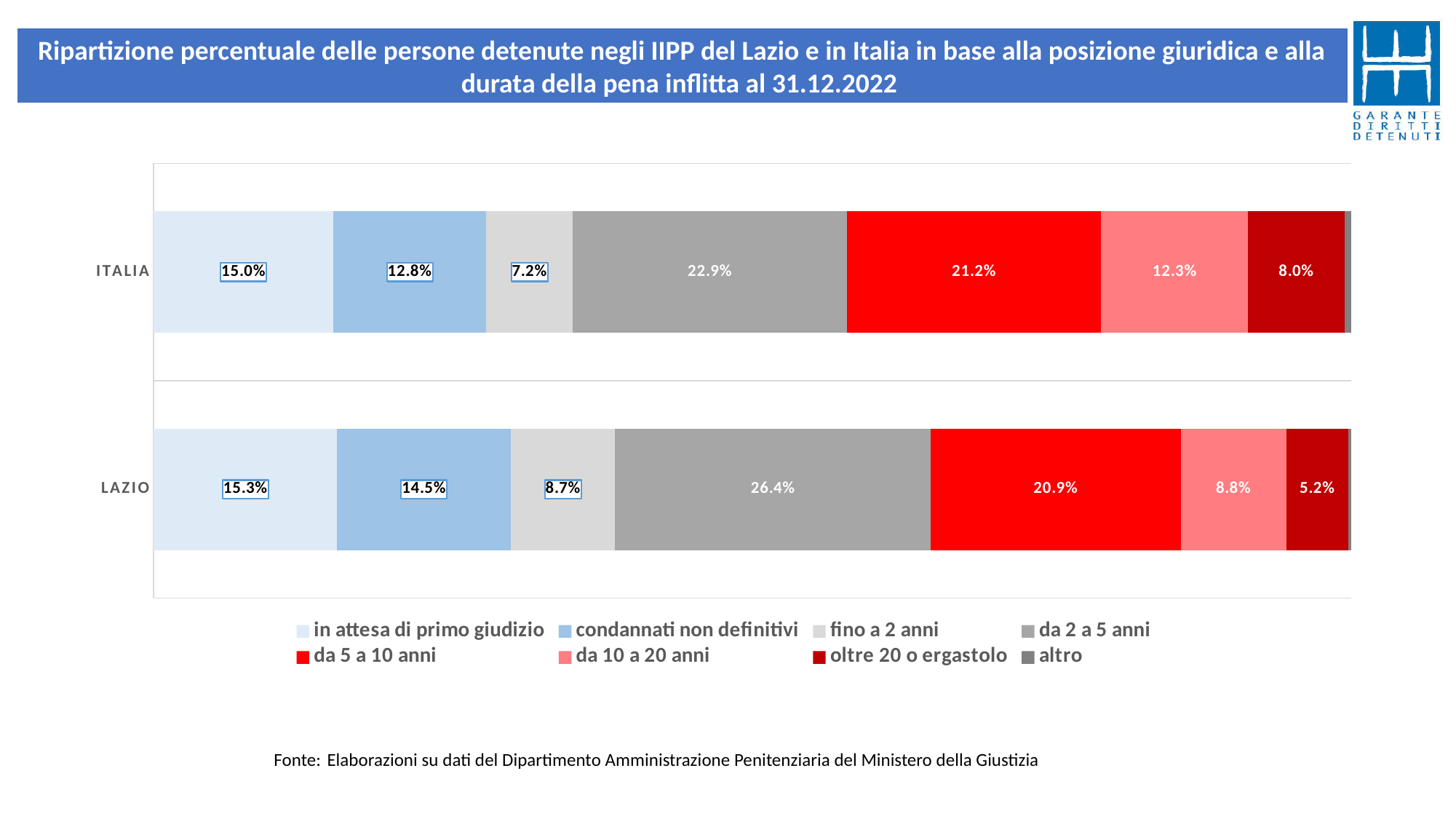
What is the difference between the 'condannati non definitivi' values for LAZIO and ITALIA? 1.7 percentage points Which has the larger 'in attesa di primo giudizio' value, ITALIA or LAZIO? LAZIO Which labelled segment has the smallest value in the ITALIA bar? fino a 2 anni Which segment has the largest value in the LAZIO bar? da 2 a 5 anni What kind of chart is shown on the slide? Stacked bar chart What is the difference between the 'da 10 a 20 anni' values for ITALIA and LAZIO? 3.5 percentage points How many bars (categories) are shown in the chart? 2 What is the value for 'fino a 2 anni' in the LAZIO bar? 8.7% What is the value for 'da 5 a 10 anni' in the LAZIO bar? 20.9% What is the value for 'da 2 a 5 anni' in the ITALIA bar? 22.9% How many series does the legend list? 8 What is the value for 'oltre 20 o ergastolo' in the ITALIA bar? 8.0%